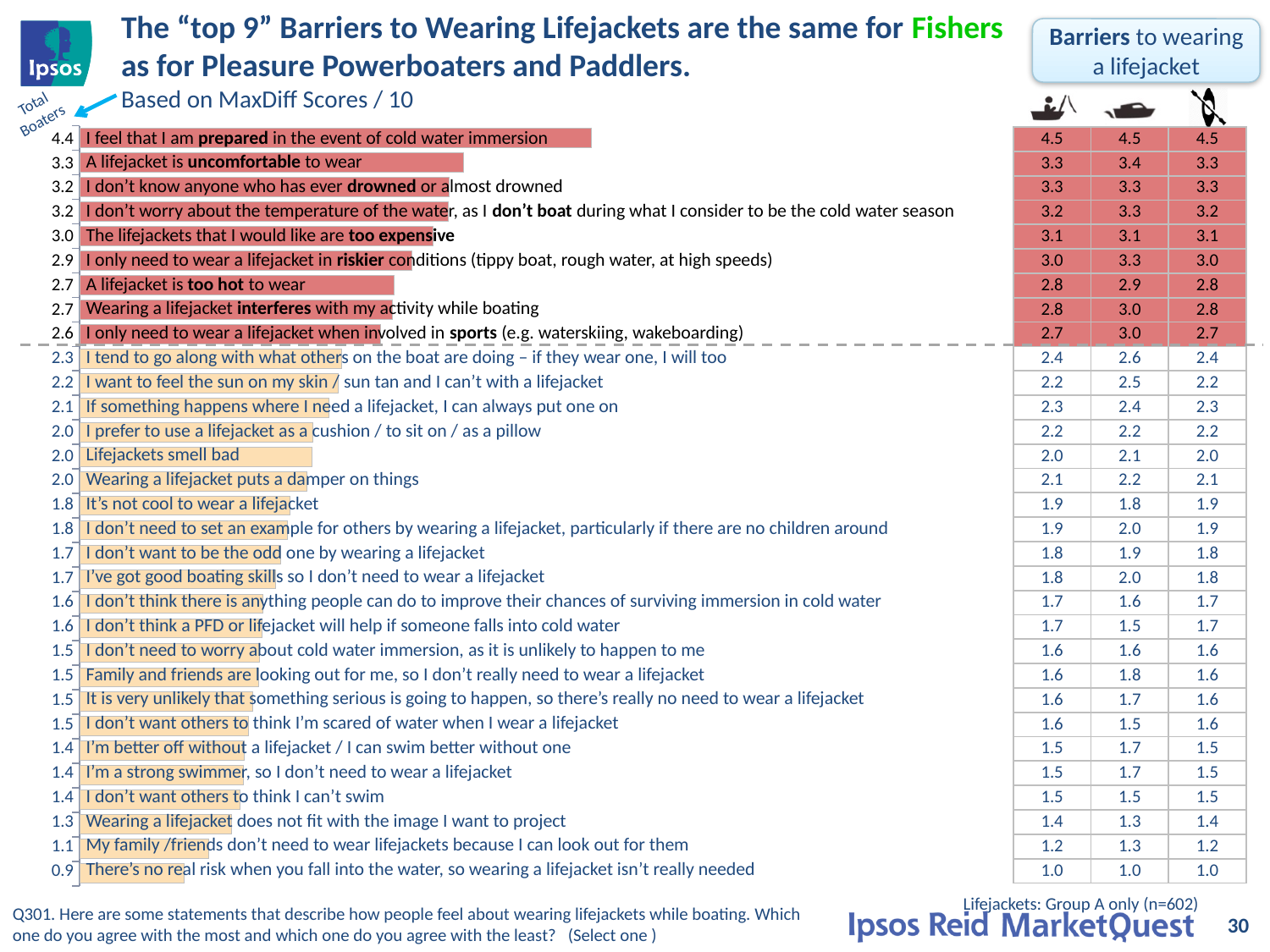
How many barrier statements are plotted in the bar chart? 31 What kind of chart is used to show the MaxDiff scores for Total Boaters? bar chart Which barrier has the lowest MaxDiff score for Total Boaters? There's no real risk when you fall into the water, so wearing a lifejacket isn't really needed What is the Total Boaters MaxDiff score for "A lifejacket is uncomfortable to wear"? 3.3 What is the difference between the Total Boaters scores for "I feel that I am prepared in the event of cold water immersion" and "A lifejacket is uncomfortable to wear"? 1.1 Which barrier has the highest MaxDiff score for Total Boaters? I feel that I am prepared in the event of cold water immersion What is the Total Boaters MaxDiff score for "It's not cool to wear a lifejacket"? 1.8 What is the Total Boaters MaxDiff score for "The lifejackets that I would like are too expensive"? 3.0 Are the bars ordered in ascending or descending order of score from top to bottom? descending Which has the higher Total Boaters score: "A lifejacket is too hot to wear" or "I tend to go along with what others on the boat are doing"? A lifejacket is too hot to wear What is the Total Boaters MaxDiff score for "Lifejackets smell bad"? 2.0 How many bars are highlighted in red as the "top 9" barriers? 9